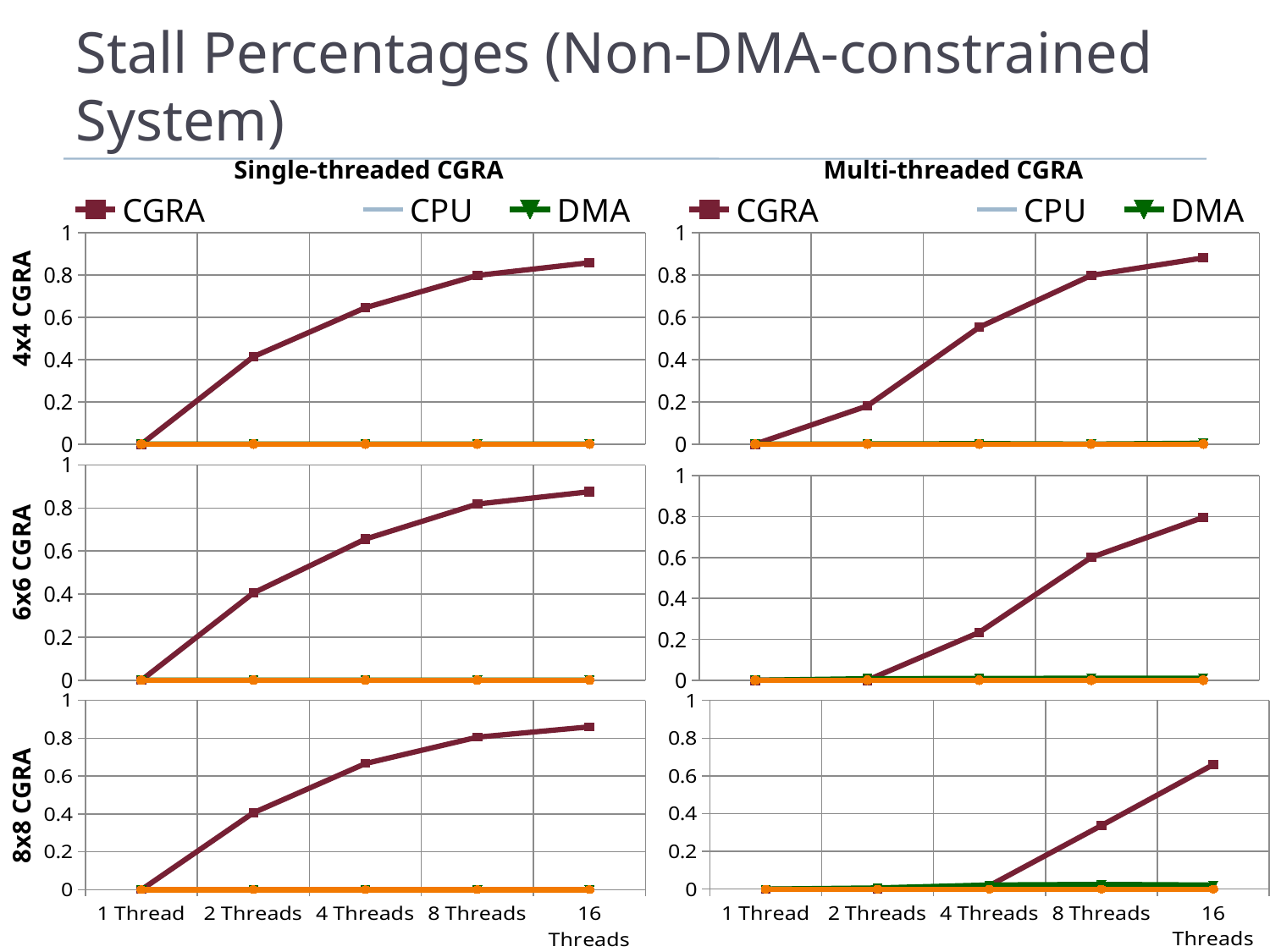
In the 4x4 CGRA Multi-threaded CGRA chart, is the CGRA value larger at 2 Threads or at 4 Threads? 4 Threads What kind of chart is used in the 4x4 CGRA Single-threaded CGRA panel? line chart In the 6x6 CGRA Multi-threaded CGRA chart, is the CGRA value at 8 Threads greater or less than 0.4? greater In the 4x4 CGRA Single-threaded CGRA chart, is the CGRA value at 16 Threads greater or less than 0.8? greater How many series does the legend list for the Single-threaded CGRA charts? 3 In the 4x4 CGRA Multi-threaded CGRA chart, is the CGRA value at 4 Threads greater or less than 0.4? greater For the 8x8 CGRA row, which chart shows the larger CGRA value at 16 Threads: Single-threaded CGRA or Multi-threaded CGRA? Single-threaded CGRA Which series is drawn in dark red with square markers in the charts? CGRA How many thread-count categories are shown on the x axis of the 8x8 CGRA Multi-threaded CGRA chart? 5 In the 4x4 CGRA Single-threaded CGRA chart, does the CGRA series rise or fall as the number of threads increases? rise